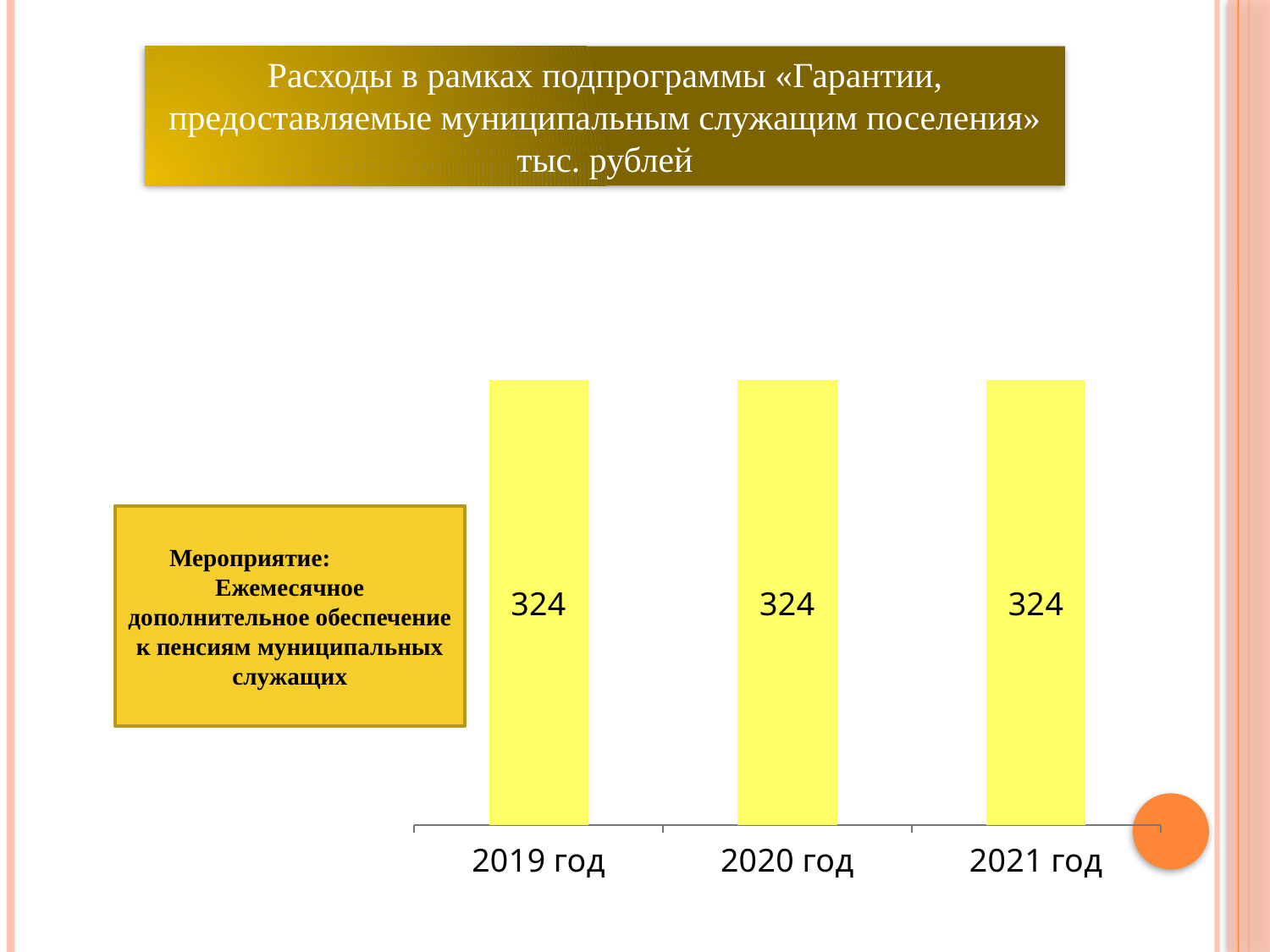
What is the value for 2021 год? 324 What kind of chart is shown on the slide? bar chart What colour are the bars in the chart? yellow Is the value for 2020 год larger than, smaller than or equal to the value for 2019 год? equal Do the values rise, fall or stay the same from 2019 год to 2021 год? stay the same What is the difference between the values for 2021 год and 2019 год? 0 What is the value for 2019 год? 324 What is the total of the values for 2019 год, 2020 год and 2021 год? 972 How many categories are shown on the x axis of the chart? 3 What is the value for 2020 год? 324 In what units are the values in the chart expressed, according to the title? тыс. рублей